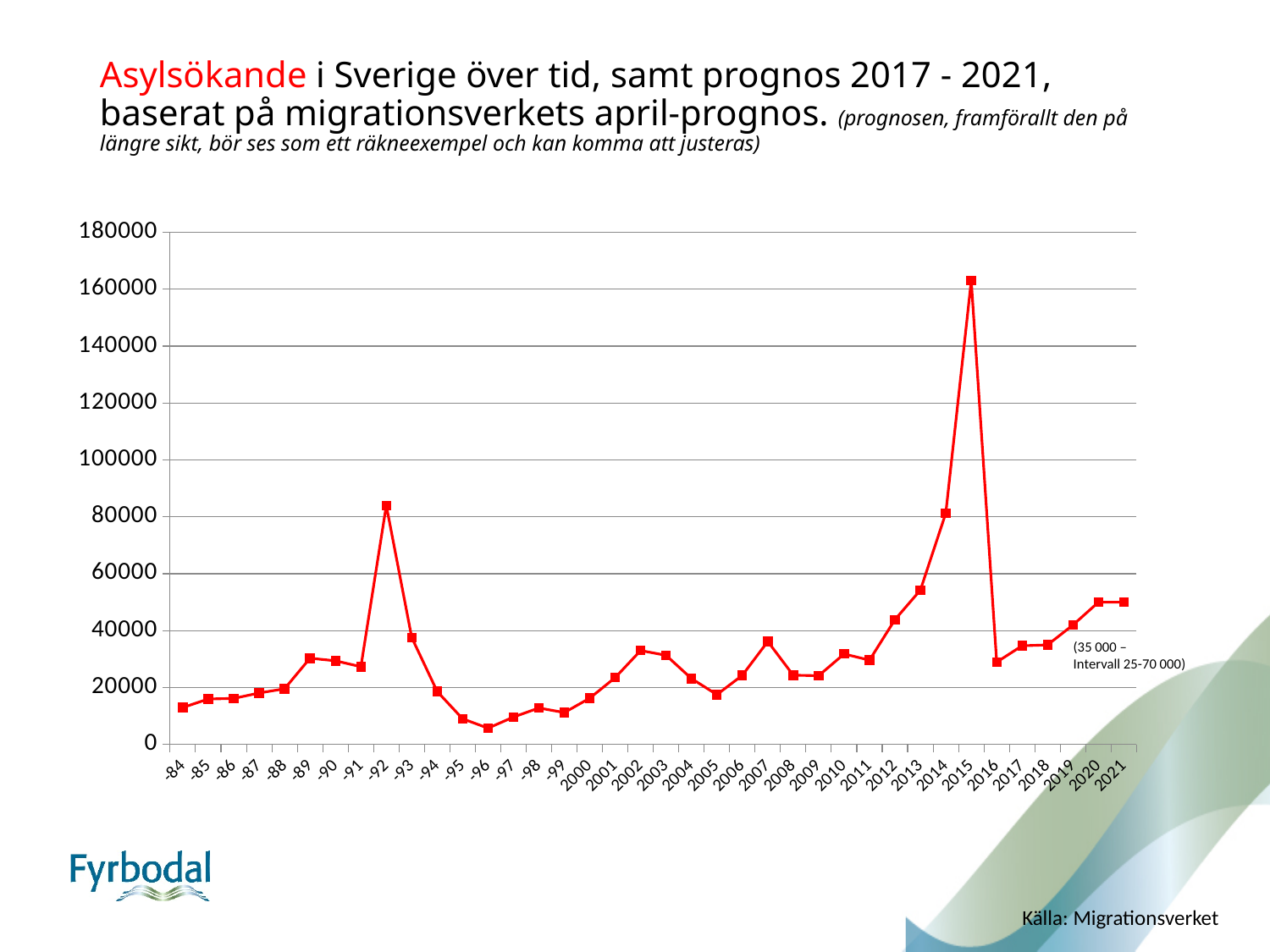
Is the value for 2016 greater or less than 40000? less Which year has the lowest number of asylum seekers in the chart? -96 Is the value for -92 greater or less than 60000? greater What source is cited for the chart data? Migrationsverket Do the values rise or fall from 2016 to 2021? rise Which year has the larger value, 2013 or 2014? 2014 How many years (data points) are plotted along the x axis? 38 What kind of chart is shown on the slide? line chart Is the value for -96 greater or less than 20000? less Which year has the larger value, -92 or 2015? 2015 Which year has the highest number of asylum seekers in the chart? 2015